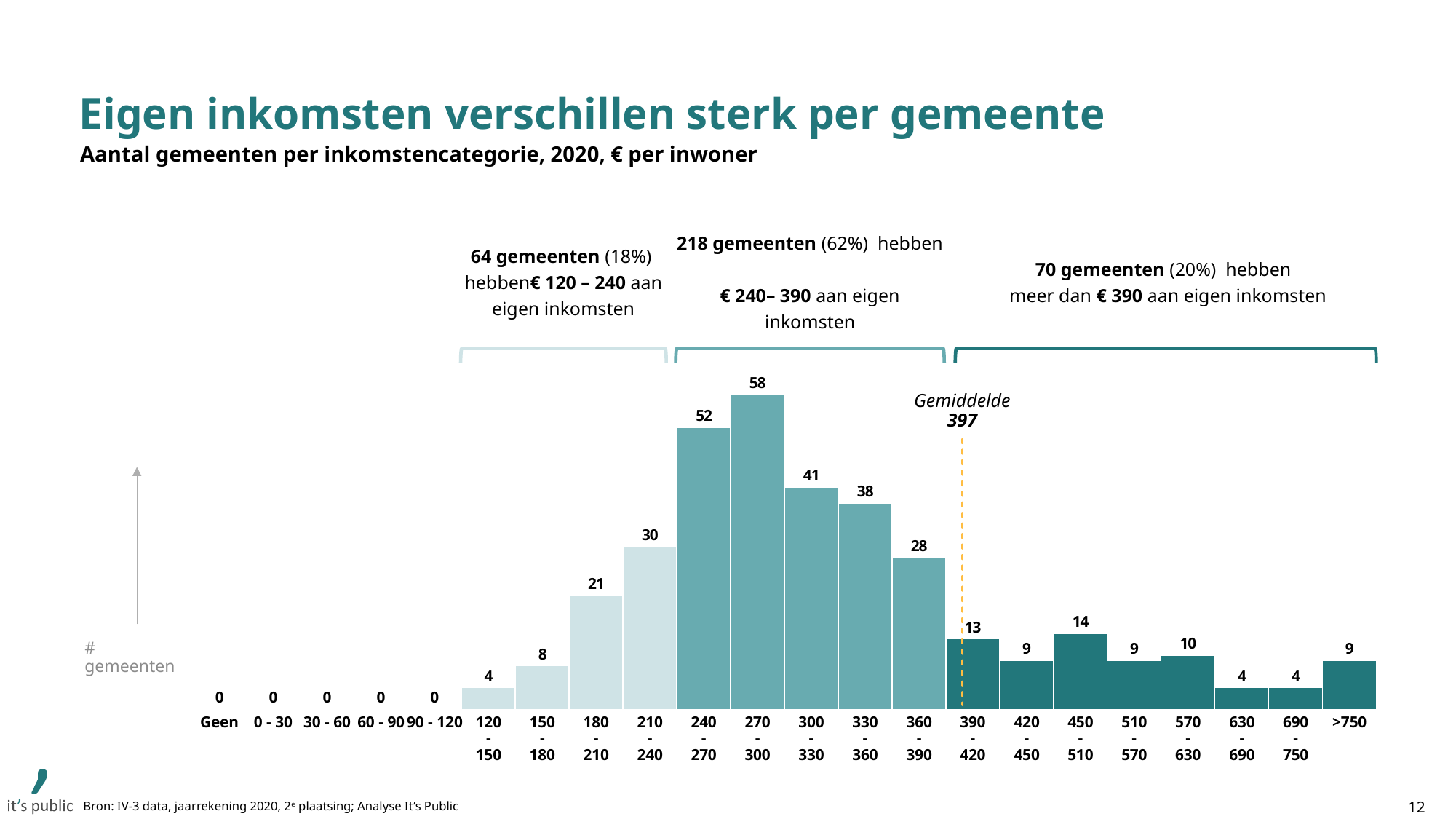
Which income category has the highest number of municipalities? 270 - 300 How many municipalities are in the 270 - 300 income category? 58 How many municipalities fall in the >750 category? 9 What average value (Gemiddelde) is marked by the dashed line on the chart? 397 What type of chart is shown on the slide? Bar chart Which has more municipalities, the 450 - 510 category or the 510 - 570 category? 450 - 510 Do the values rise or fall from the 270 - 300 category to the 360 - 390 category? Fall Which has more municipalities, the 210 - 240 category or the 390 - 420 category? 210 - 240 What is the value for the 180 - 210 category? 21 How many income categories are shown on the x axis? 22 What is the difference between the 240 - 270 and 270 - 300 categories? 6 What is the difference between the 300 - 330 and 360 - 390 categories? 13